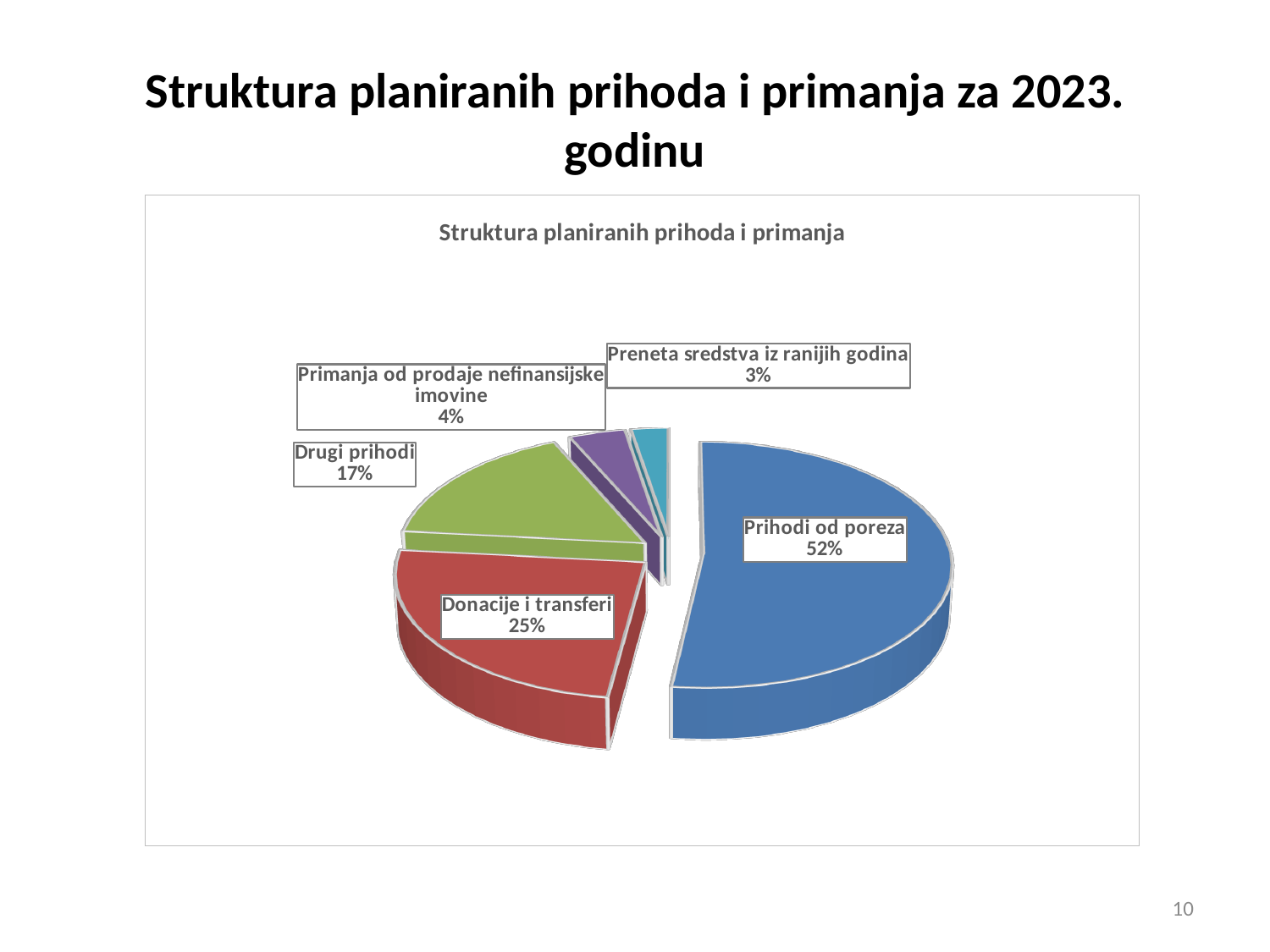
What share of the pie does Prihodi od poreza represent? 52% What is the difference in percentage points between Prihodi od poreza and Donacije i transferi? 27 What share of the pie does Primanja od prodaje nefinansijske imovine represent? 4% What is the title of the chart? Struktura planiranih prihoda i primanja What share of the pie does Drugi prihodi represent? 17% Which category has the largest slice of the pie? Prihodi od poreza Which category has the smallest slice of the pie? Preneta sredstva iz ranijih godina What kind of chart is shown on the slide? Pie chart How many slices does the pie chart have? 5 Which is larger, the share for Drugi prihodi or the share for Donacije i transferi? Donacije i transferi